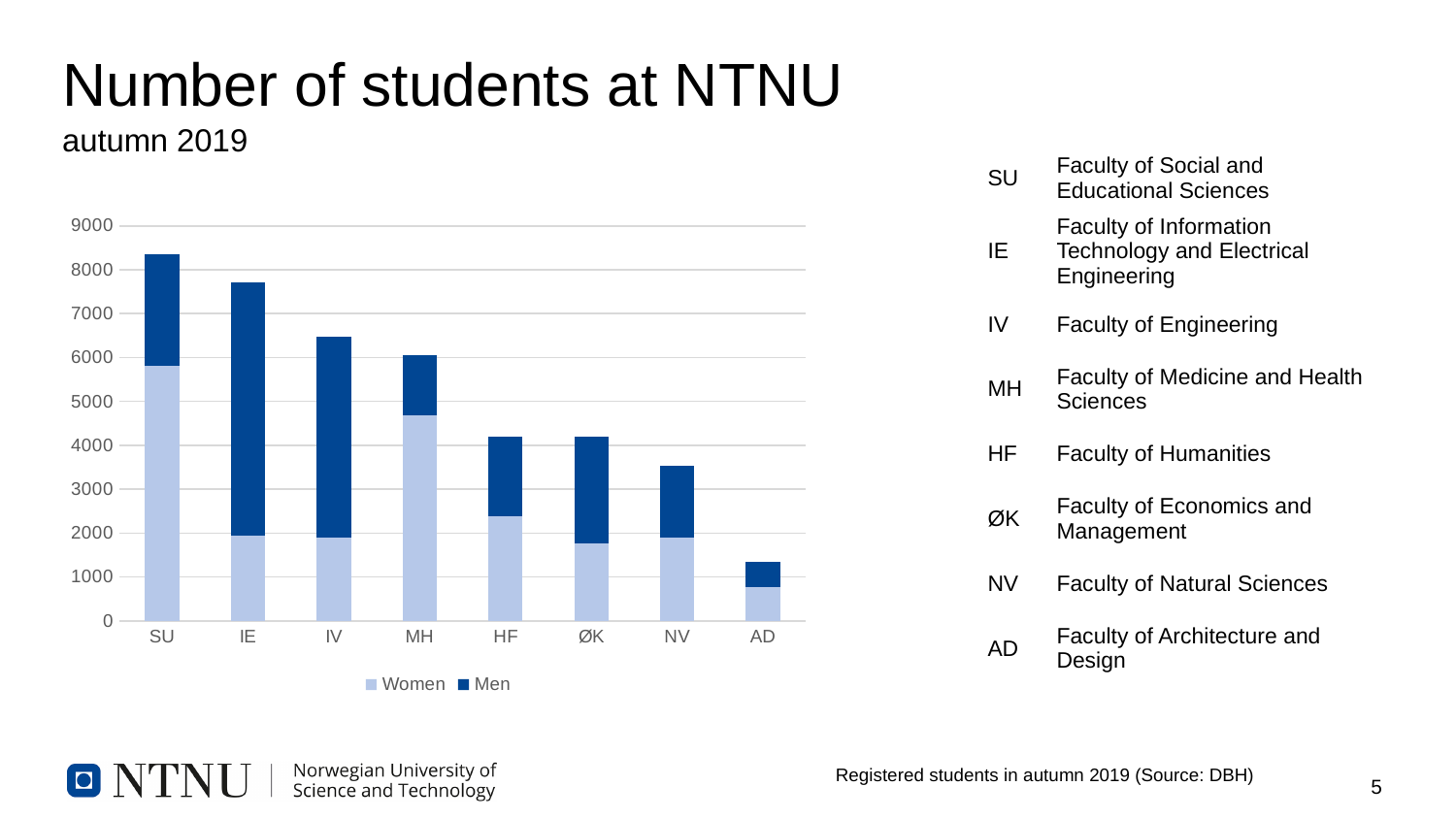
Is the number of women at MH greater or less than 4000? greater Which faculty has more students in total, IE or IV? IE Which faculty has the highest total number of students? SU How many series does the chart legend list? 2 Is the total number of students for AD greater or less than 2000? less Is the total number of students for NV greater or less than 4000? less Which faculty has the lowest total number of students? AD How many faculties are shown on the x axis of the chart? 8 What kind of chart is shown on the slide? Stacked bar chart Which faculty has more women students, SU or MH? SU What are the two series named in the chart legend? Women and Men